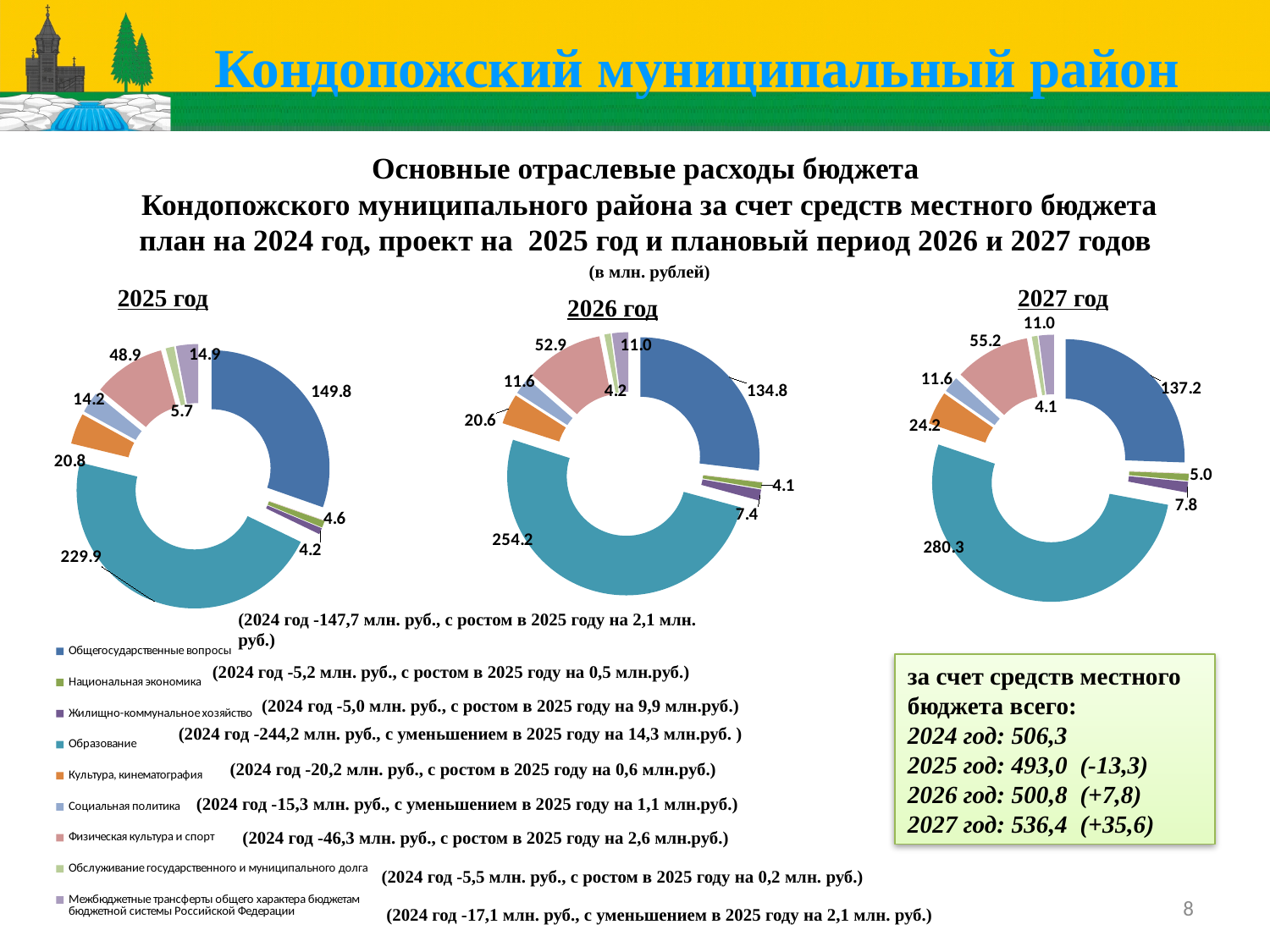
In the 2026 год chart, which category has the largest value? Образование Which colour represents Образование in the charts? Teal (blue-green) Does the value for Образование rise or fall from the 2025 год chart to the 2027 год chart? Rises What is the difference between the Общегосударственные вопросы value in the 2025 год chart and in the 2026 год chart? 15.0 Is the value for Социальная политика larger in the 2025 год chart or in the 2026 год chart? 2025 год What is the difference between the Образование value in the 2027 год chart and in the 2026 год chart? 26.1 In the 2025 год chart, what is the value for Образование? 229.9 In the 2027 год chart, what is the value for Культура, кинематография? 24.2 In the 2026 год chart, what is the value for Физическая культура и спорт? 52.9 In the 2027 год chart, which category has the smallest value? Обслуживание государственного и муниципального долга How many categories does the legend list for the charts? 9 What kind of chart is used for the 2025 год, 2026 год and 2027 год data? Pie (doughnut) chart